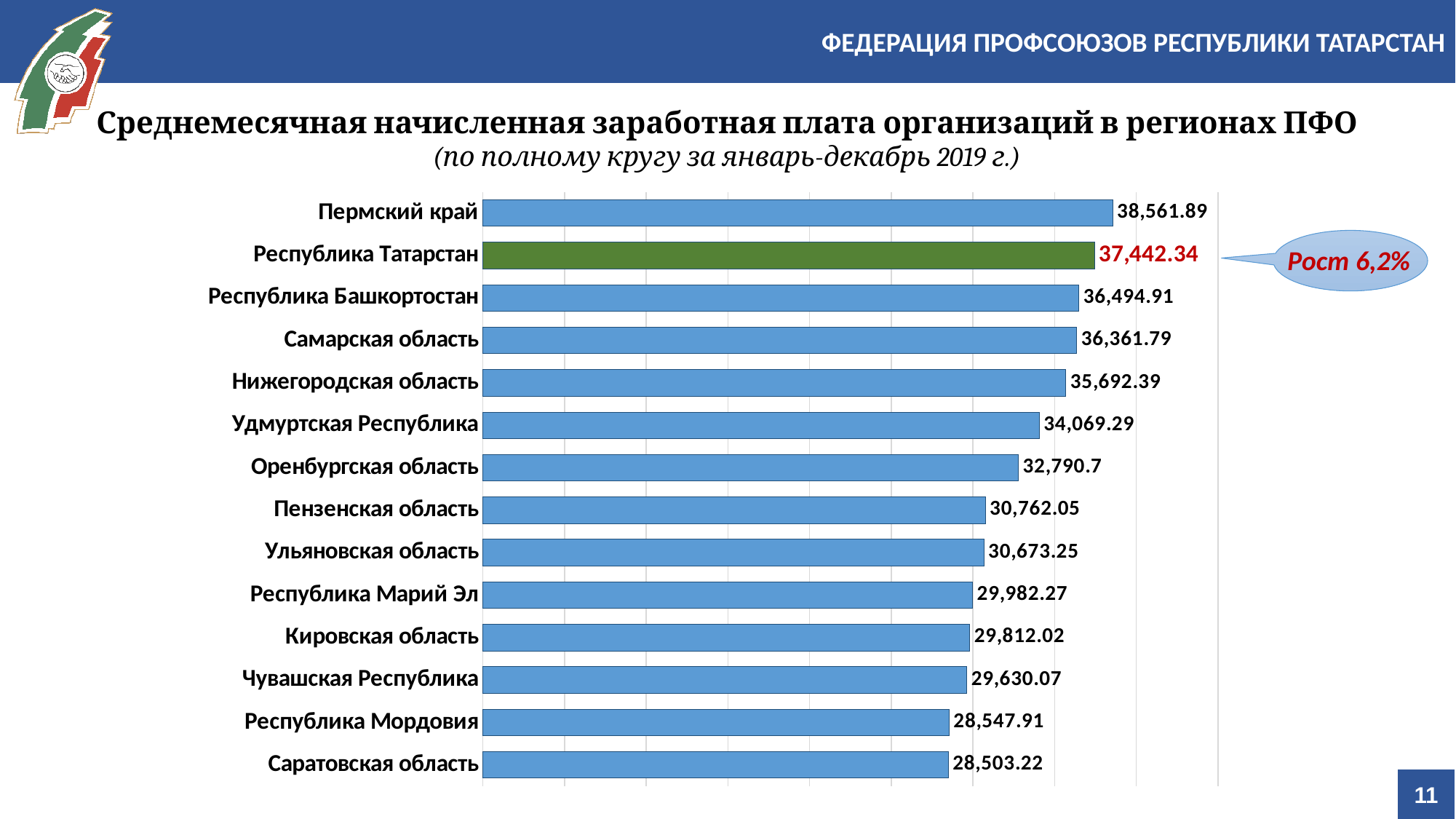
What is the value for Республика Татарстан? 37,442.34 Which region has the lowest value? Саратовская область What is the difference between the values for Пермский край and Республика Татарстан? 1,119.55 Which region has the highest value? Пермский край What kind of chart is shown on the slide? Bar chart What is the value for Оренбургская область? 32,790.7 Which is larger, the value for Удмуртская Республика or Оренбургская область? Удмуртская Республика How many regions are shown in the chart? 14 Do the values rise or fall going from the top bar to the bottom bar? Fall What is the difference between the values for Республика Татарстан and Республика Башкортостан? 947.43 Which region's bar is coloured green instead of blue? Республика Татарстан What is the value for Нижегородская область? 35,692.39